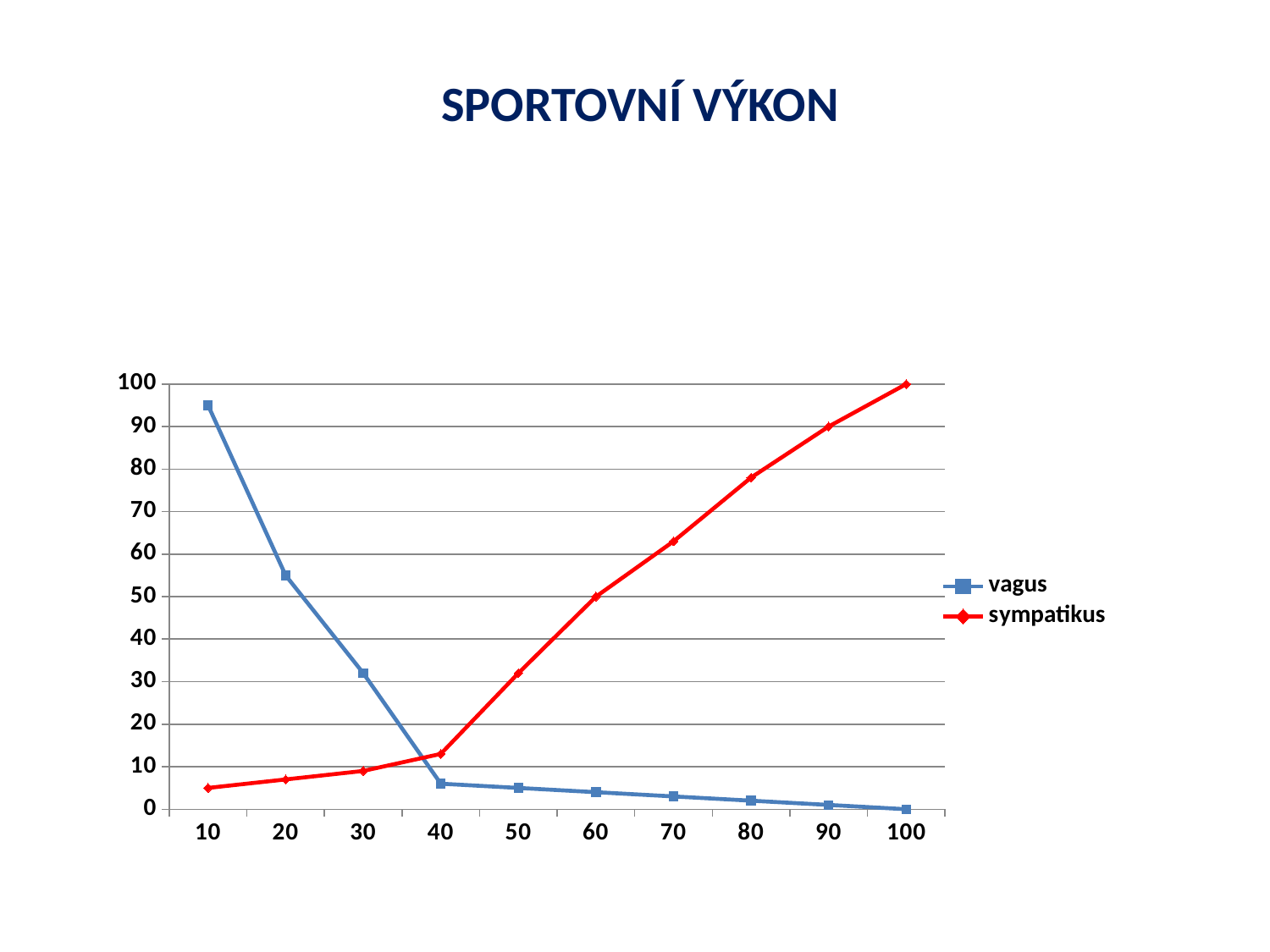
Is the value for sympatikus at x = 70 greater or less than 60? greater How many series does the legend list? 2 At x = 20, which series has the larger value, vagus or sympatikus? vagus What is the value of vagus at x = 100? 0 How many points are plotted along the x axis for each series? 10 What is the value of sympatikus at x = 60? 50 What is the title of the chart? SPORTOVNÍ VÝKON Is the value for sympatikus at x = 10 greater or less than 10? less Do the values for vagus rise or fall as x increases from 10 to 100? fall What kind of chart is shown on the slide? line chart Is the value for vagus at x = 10 greater or less than 90? greater What is the value of sympatikus at x = 100? 100